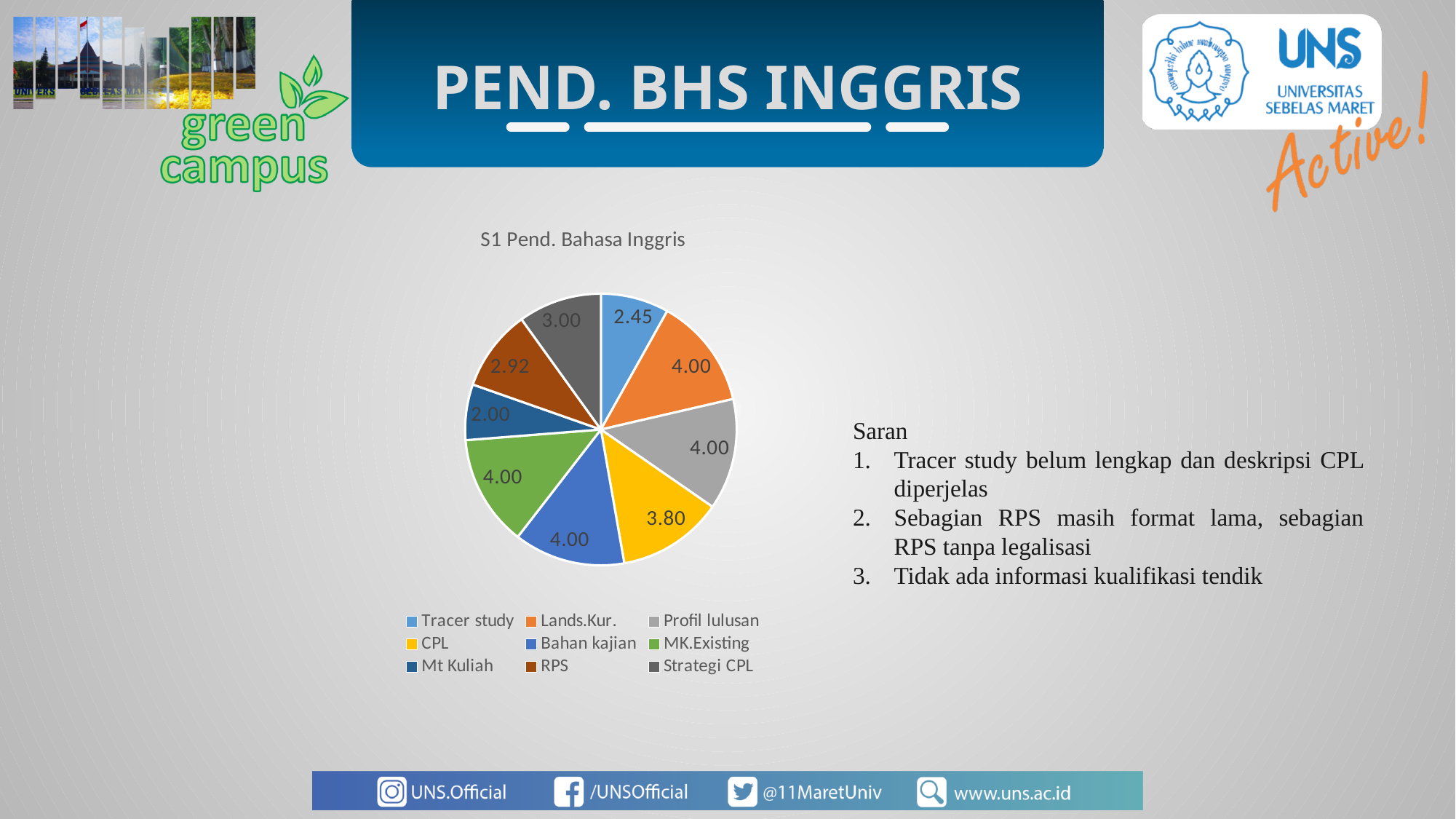
What is the value for RPS? 2.92 What is the value for Mt Kuliah? 2.00 What is the value for CPL? 3.80 What is the value for Strategi CPL? 3.00 Which is larger, the value for CPL or the value for Strategi CPL? CPL What kind of chart is shown on the slide? pie chart What colour is the slice for MK.Existing? green What is the title of the chart? S1 Pend. Bahasa Inggris How many categories does the pie chart have? 9 What is the value for Tracer study? 2.45 What is the difference between the values for Lands.Kur. and Tracer study? 1.55 Which category has the lowest value? Mt Kuliah